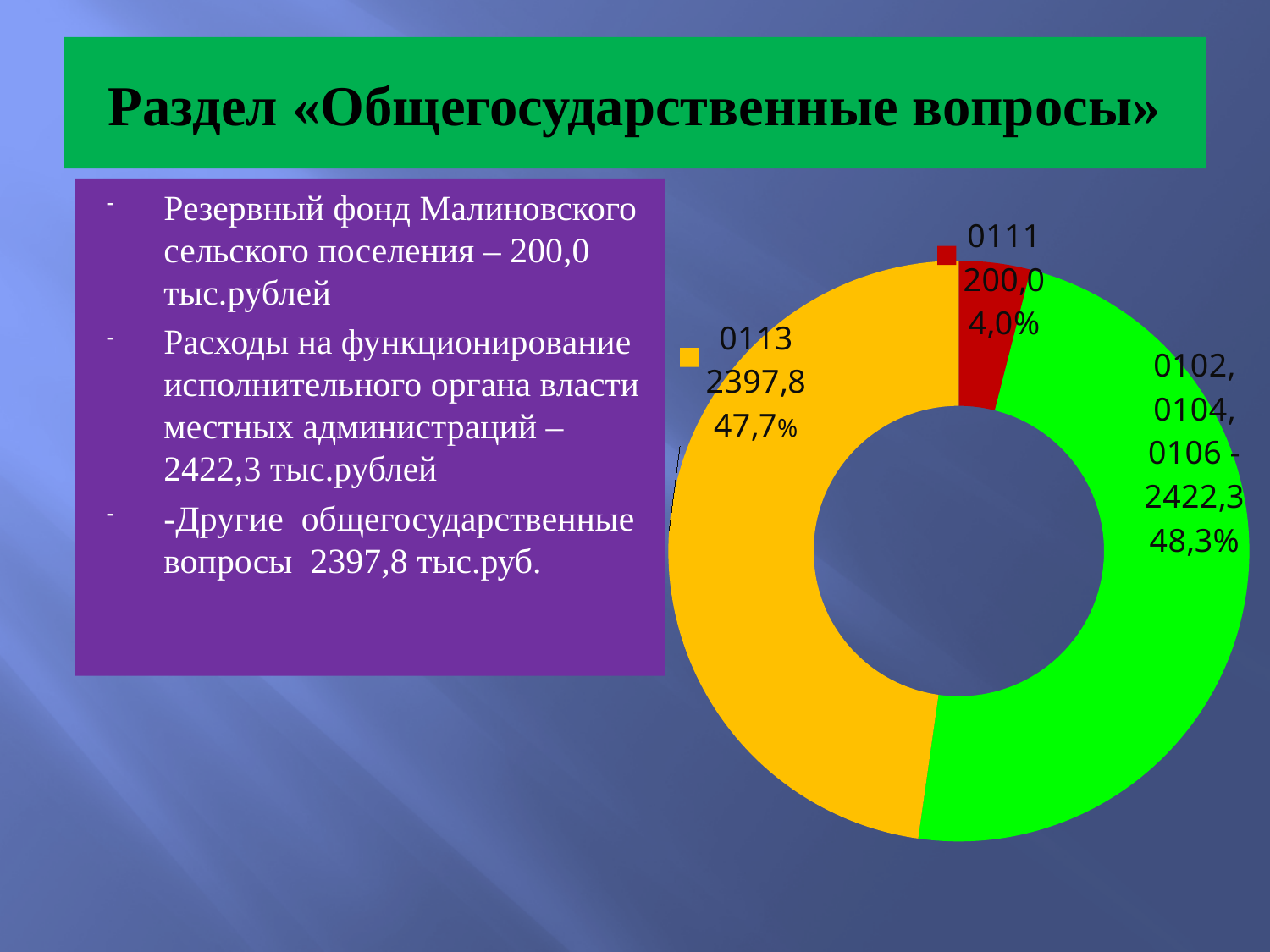
What kind of chart is shown on the slide? doughnut chart Which slice has the smallest value? 0111 What percentage share does slice 0111 have? 4,0% How many slices does the chart have? 3 What percentage share does slice 0113 have? 47,7% What percentage share does the slice labelled 0102, 0104, 0106 have? 48,3% What is the difference between the values of slice 0113 and slice 0111? 2197,8 What colour is the slice for 0113? yellow (orange) What value is shown for the slice labelled 0102, 0104, 0106? 2422,3 What value is shown for slice 0111? 200,0 Which slice has the largest value? 0102, 0104, 0106 What value is shown for slice 0113? 2397,8